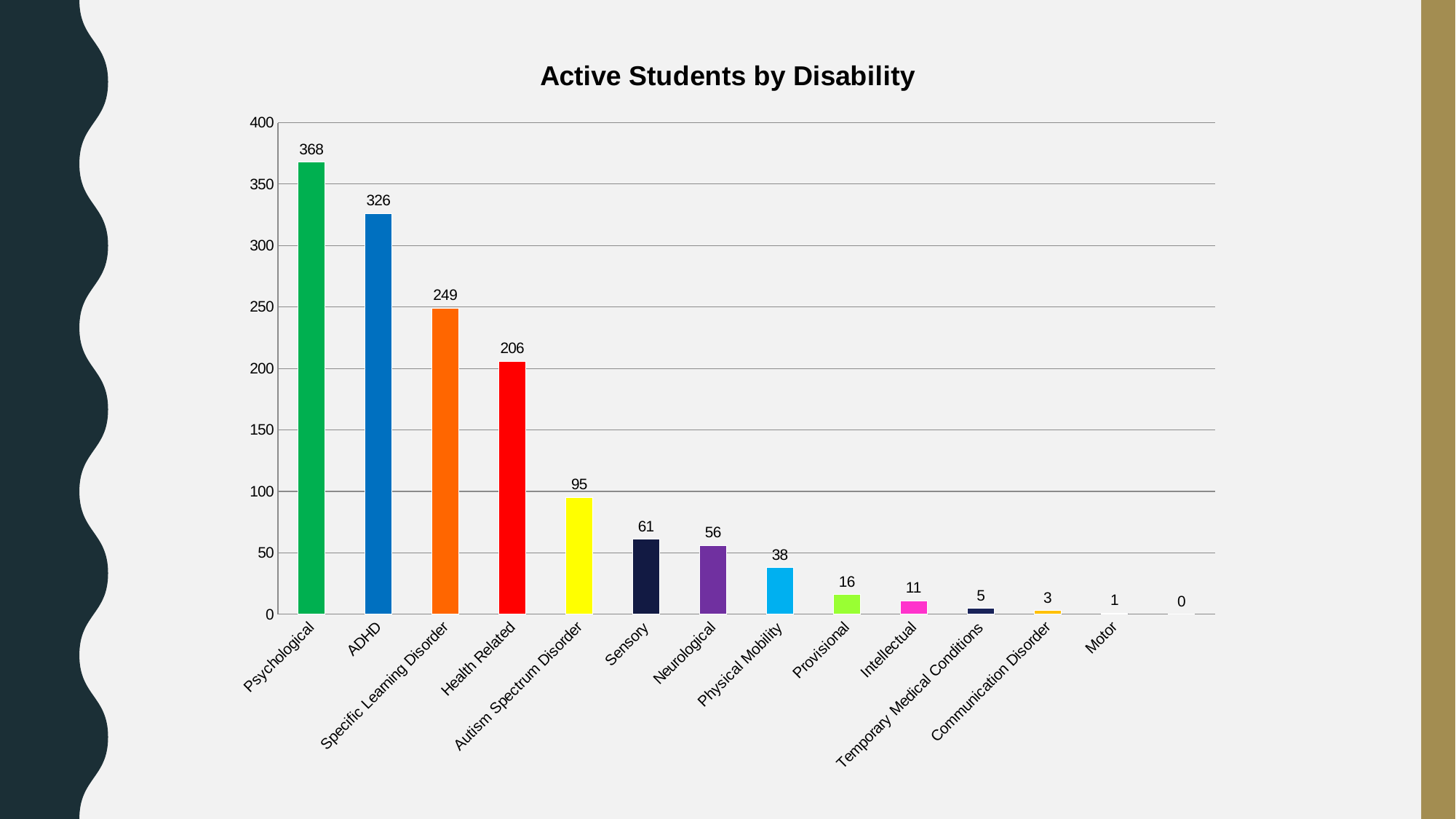
Which is larger, the value for Sensory or the value for Neurological? Sensory Is the value for Health Related greater or less than 200? greater Which category has the highest value? Psychological What is the value for Motor? 1 What is the value for Temporary Medical Conditions? 5 What kind of chart is shown on the slide? bar chart Which is larger, the value for Provisional or the value for Intellectual? Provisional What is the value for Autism Spectrum Disorder? 95 What is the difference between the values for Psychological and ADHD? 42 What is the title of the chart? Active Students by Disability What is the difference between the values for Specific Learning Disorder and Health Related? 43 What is the value for Psychological? 368